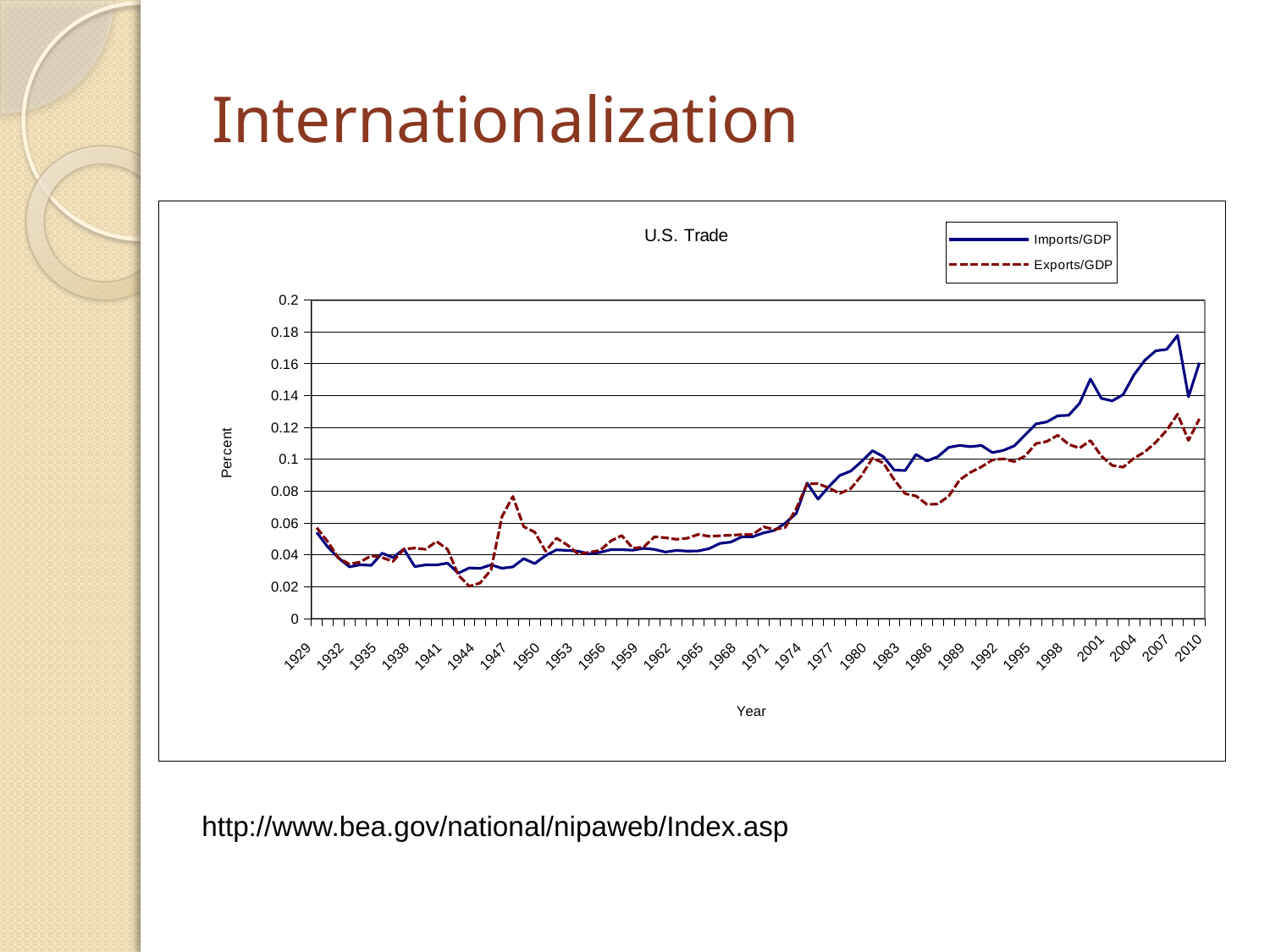
Which series reaches the highest value anywhere on the chart, Imports/GDP or Exports/GDP? Imports/GDP In 2010, which is higher, Imports/GDP or Exports/GDP? Imports/GDP Is the value of Imports/GDP in 1929 greater or less than 0.1? less Overall, does the Imports/GDP line rise or fall from 1929 to 2010? rise What is the title of the chart? U.S. Trade In 1947, which is higher, Imports/GDP or Exports/GDP? Exports/GDP Is the value of Imports/GDP in 2007 greater or less than 0.14? greater Is the value of Imports/GDP in 1980 greater or less than 0.08? greater What kind of chart is shown on the slide? line chart How many series does the legend of the U.S. Trade chart list? 2 What is the label on the vertical axis of the chart? Percent